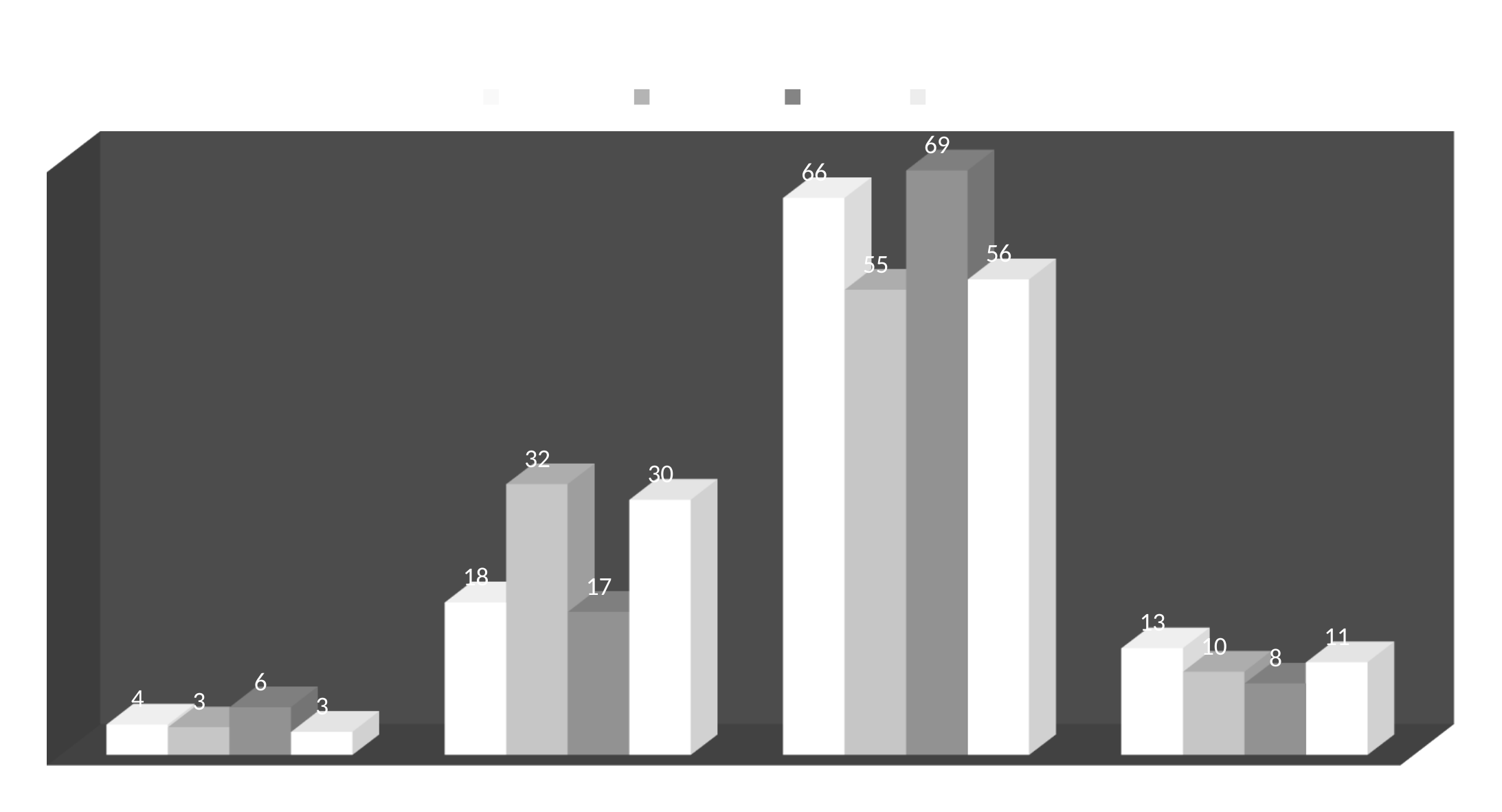
Which group of bars has the tallest bars overall? the third group from the left What is the value of the last (rightmost) bar in the fourth group? 11 How many series does the legend list? 4 What is the difference between the first bar of the fourth group (13) and the third bar of the fourth group (8)? 5 What is the value of the first (leftmost) bar in the third group from the left? 66 What is the difference between the third bar (69) and the second bar (55) in the third group? 14 In the second group from the left, which is larger: the first bar (18) or the third bar (17)? the first bar (18) What is the highest value labelled on the chart? 69 What is the value of the second bar in the second group from the left? 32 What is the lowest value labelled on the chart? 3 How many groups of bars are plotted along the x axis? 4 What kind of chart is shown on the slide? bar chart